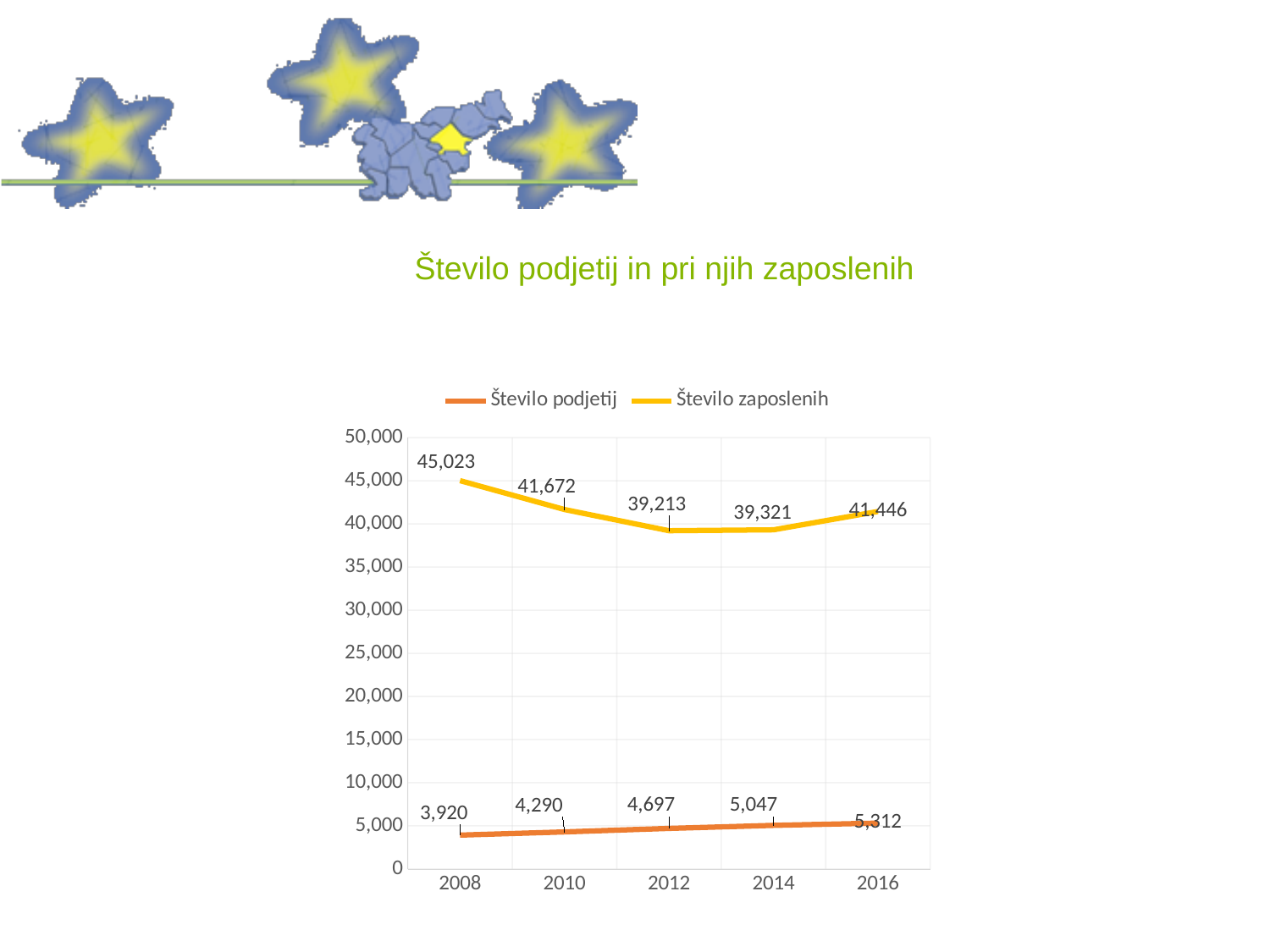
Does Število podjetij rise or fall from 2008 to 2016? rise What is the value of Število podjetij in 2016? 5,312 Which is larger: Število zaposlenih in 2010 or in 2014? 2010 How many years are shown on the x axis? 5 What is the value of Število zaposlenih in 2008? 45,023 In which year is Število podjetij highest? 2016 What is the difference between Število podjetij in 2016 and in 2008? 1,392 What kind of chart is shown on the slide? line chart What is the difference between Število zaposlenih in 2008 and in 2016? 3,577 How many series does the legend list? 2 What is the value of Število zaposlenih in 2012? 39,213 In which year is Število zaposlenih lowest? 2012